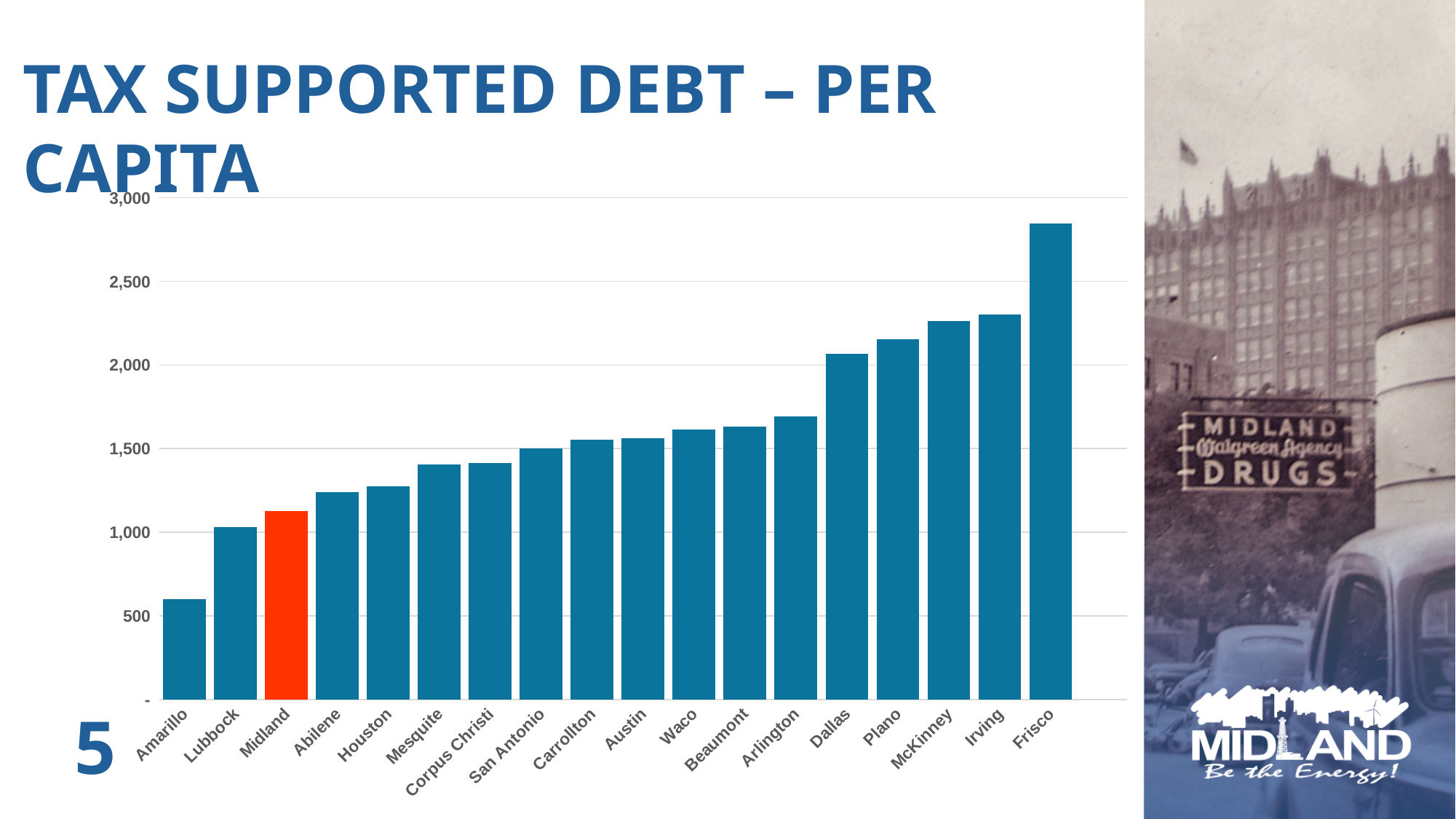
How many cities are shown on the chart? 18 Do the values rise or fall moving from left to right along the x axis? rise Is the value for Frisco greater or less than 2,500? greater Which has a higher tax supported debt per capita, Dallas or Midland? Dallas Which city's bar is highlighted in a different colour (orange) from the others? Midland Is the value for Amarillo greater or less than 500? greater Which city has the highest tax supported debt per capita? Frisco What kind of chart is shown on the slide? bar chart Is the value for Arlington greater or less than 2,000? less Which city has the lowest tax supported debt per capita? Amarillo